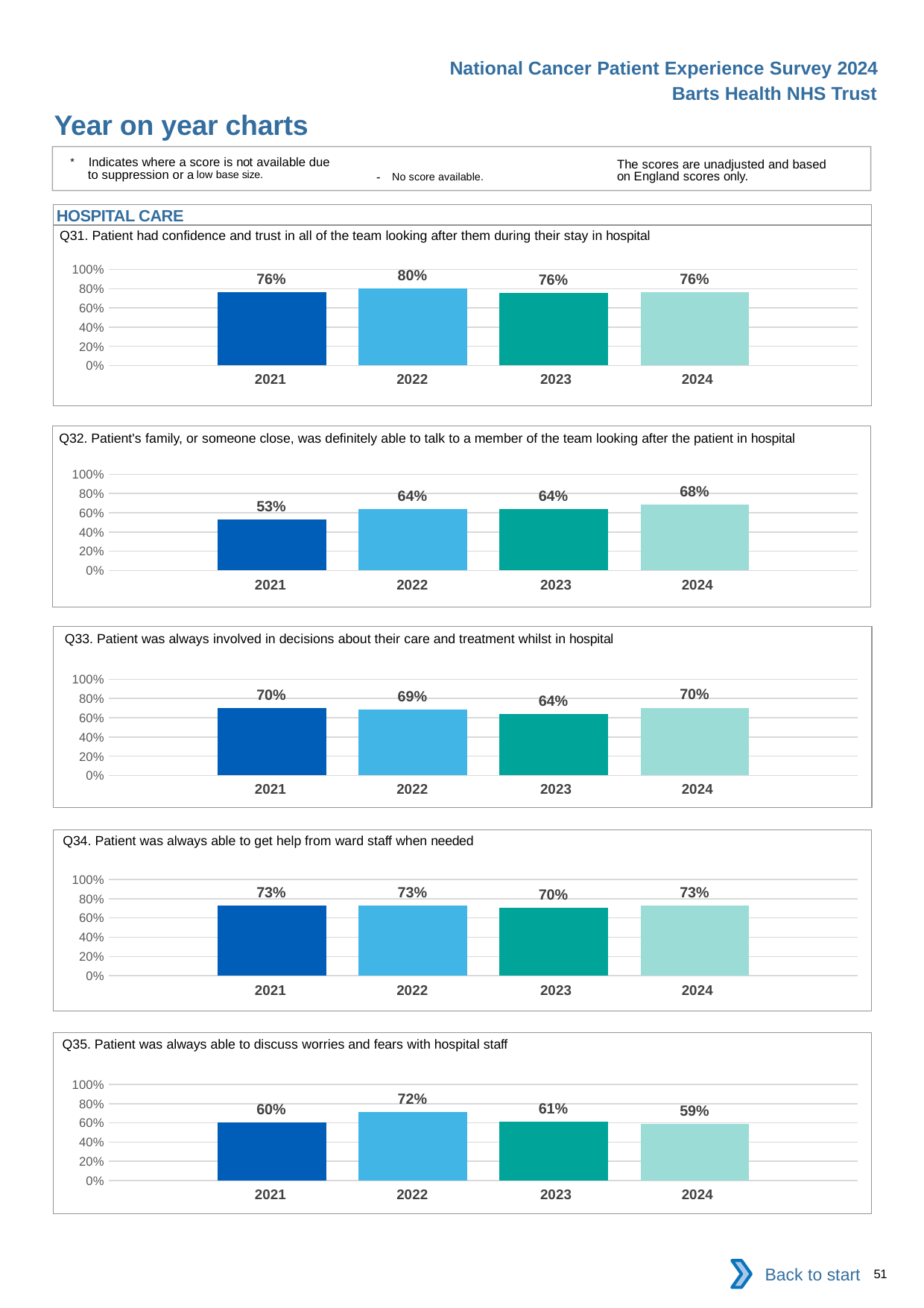
In the Q31 chart (confidence and trust in all of the team), what is the value for 2022? 80% In the Q35 chart (able to discuss worries and fears), is the value for 2022 larger or smaller than the value for 2024? larger In the Q35 chart (able to discuss worries and fears), which year has the highest value? 2022 How many years are plotted in the Q31 chart (confidence and trust in all of the team)? 4 In the Q33 chart (involved in decisions about care and treatment), what is the value for 2023? 64% In the Q32 chart (family able to talk to a member of the team), which year has the lowest value? 2021 In the Q35 chart (able to discuss worries and fears), what is the value for 2024? 59% In the Q32 chart (family able to talk to a member of the team), do the values rise or fall from 2021 to 2024? rise How many charts are shown on the slide under the HOSPITAL CARE heading? 5 What kind of chart is the Q34 chart (able to get help from ward staff)? bar chart In the Q32 chart (family able to talk to a member of the team), what is the difference between the 2024 and 2021 values? 15 percentage points In the Q34 chart (able to get help from ward staff), which year has the lowest value? 2023